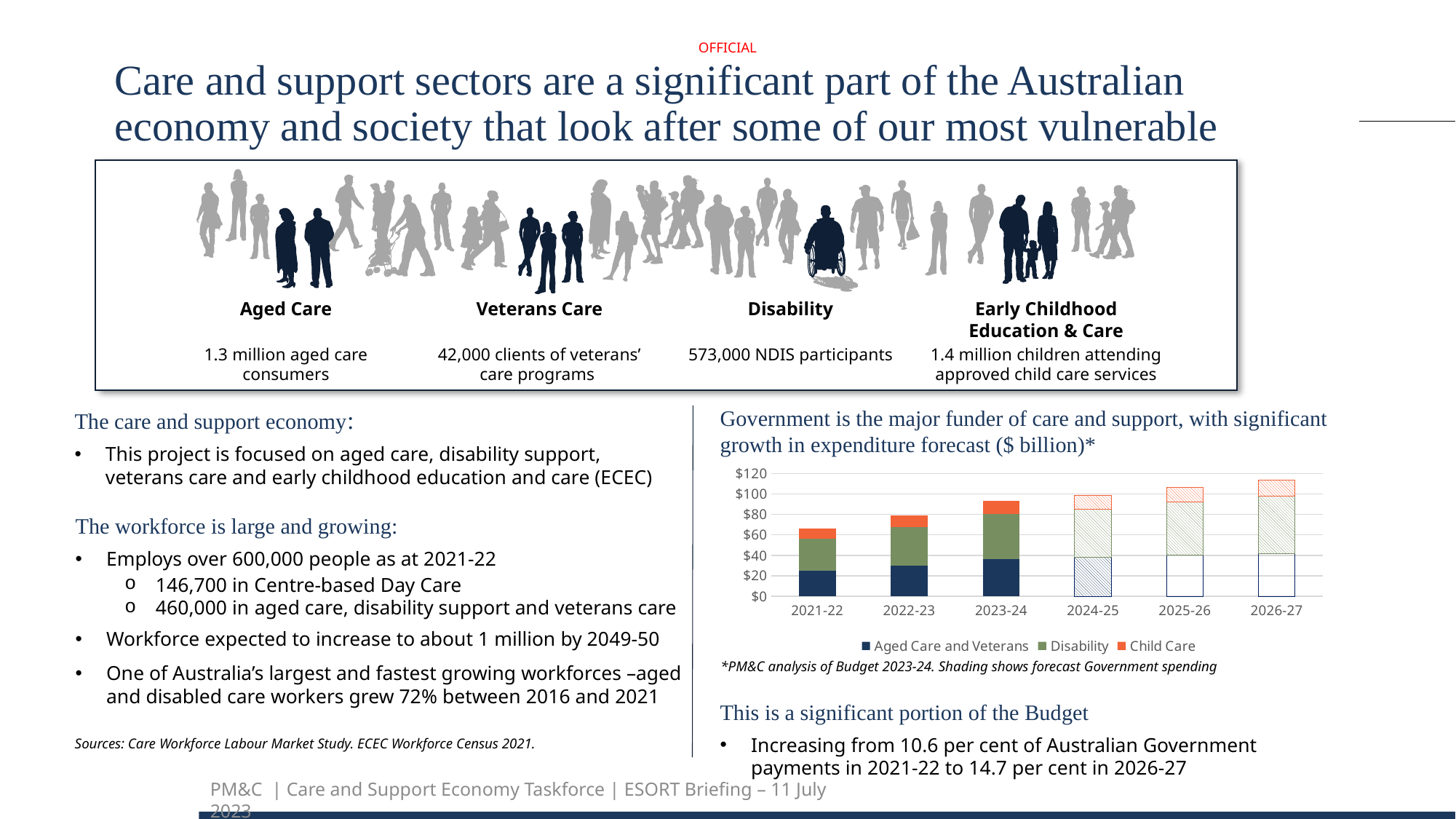
Which series is shown in the bottom segment of each stacked bar? Aged Care and Veterans How many years are shown on the x axis of the chart? 6 Is the total expenditure for 2026-27 greater or less than $100 billion? greater Is the total expenditure for 2021-22 greater or less than $60 billion? greater Is the total expenditure for 2023-24 greater or less than $100 billion? less According to the chart note, what does the shading on the bars indicate? Forecast Government spending What kind of chart is shown on the slide? Stacked bar chart Is the total expenditure for 2023-24 larger or smaller than that for 2021-22? Larger Which year has the highest total expenditure in the chart? 2026-27 How many series does the chart legend list? 3 Which year has the lowest total expenditure in the chart? 2021-22 Do the total expenditure values rise or fall from 2021-22 to 2026-27? Rise